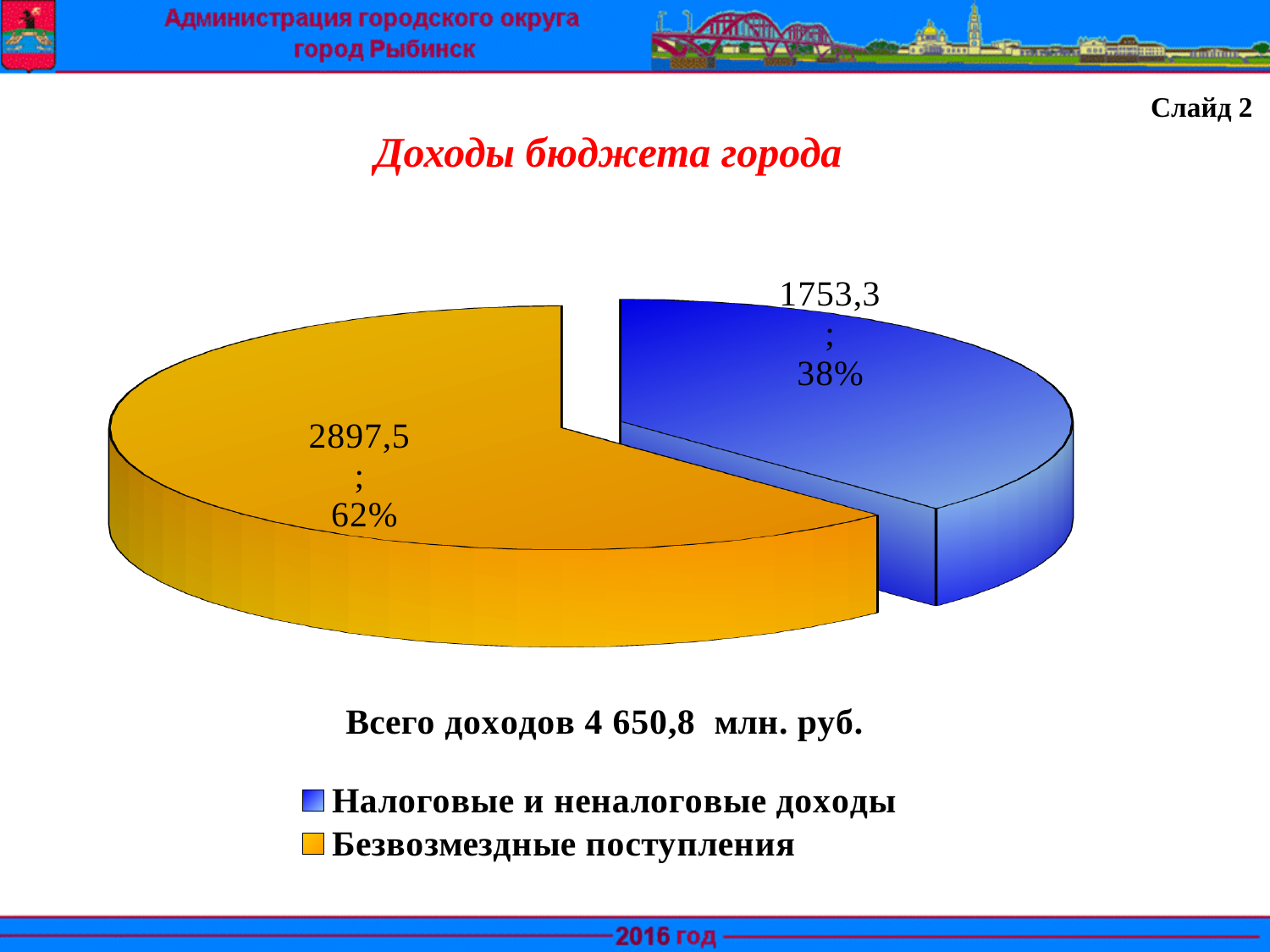
What share of the pie does Налоговые и неналоговые доходы represent? 38% Which category has the largest slice of the pie? Безвозмездные поступления What kind of chart is shown on the slide? Pie chart What is the difference between the values for Безвозмездные поступления and Налоговые и неналоговые доходы? 1144,2 What is the value for Безвозмездные поступления? 2897,5 Which category has the smallest slice of the pie? Налоговые и неналоговые доходы What is the value for Налоговые и неналоговые доходы? 1753,3 What is the title of the chart? Доходы бюджета города How many slices does the pie chart have? 2 What share of the pie does Безвозмездные поступления represent? 62% Which is larger: Налоговые и неналоговые доходы or Безвозмездные поступления? Безвозмездные поступления What colour is the slice for Безвозмездные поступления? Yellow/orange